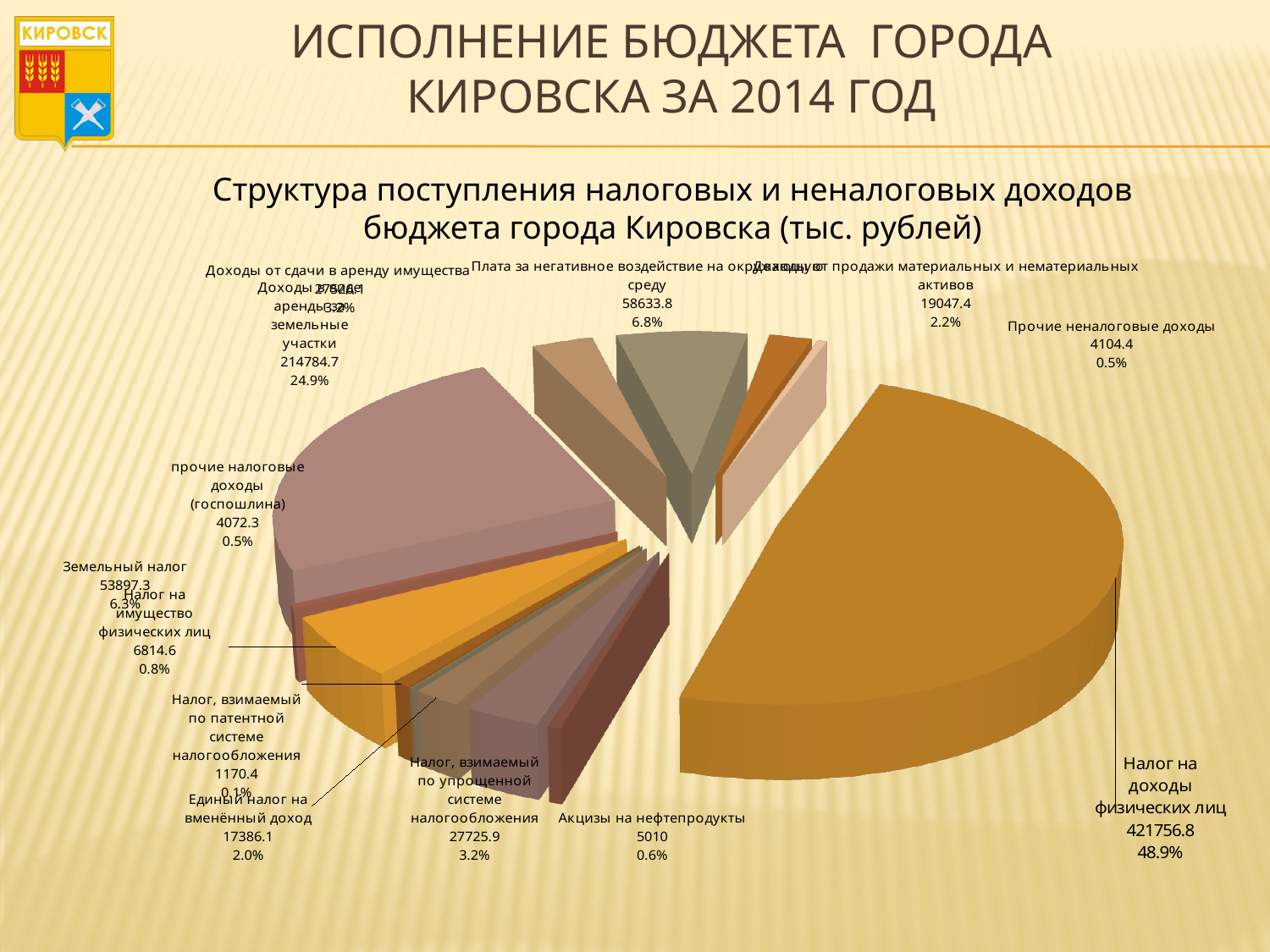
Which category has the smallest slice of the pie? Налог, взимаемый по патентной системе налогообложения Which is larger: Единый налог на вменённый доход or Налог, взимаемый по упрощенной системе налогообложения? Налог, взимаемый по упрощенной системе налогообложения What is the value shown for Налог на доходы физических лиц? 421756.8 Which category has the largest slice of the pie? Налог на доходы физических лиц What percentage is shown for Плата за негативное воздействие на окружающую среду? 6.8% What is the value shown for Земельный налог? 53897.3 What percentage is shown for Доходы от продажи материальных и нематериальных активов? 2.2% What is the value shown for Акцизы на нефтепродукты? 5010 What is the difference between the values for Земельный налог and Налог на имущество физических лиц? 47082.7 What is the title of the chart? Структура поступления налоговых и неналоговых доходов бюджета города Кировска (тыс. рублей) What share of the pie does Налог на доходы физических лиц represent? 48.9% What kind of chart is shown on the slide? pie chart